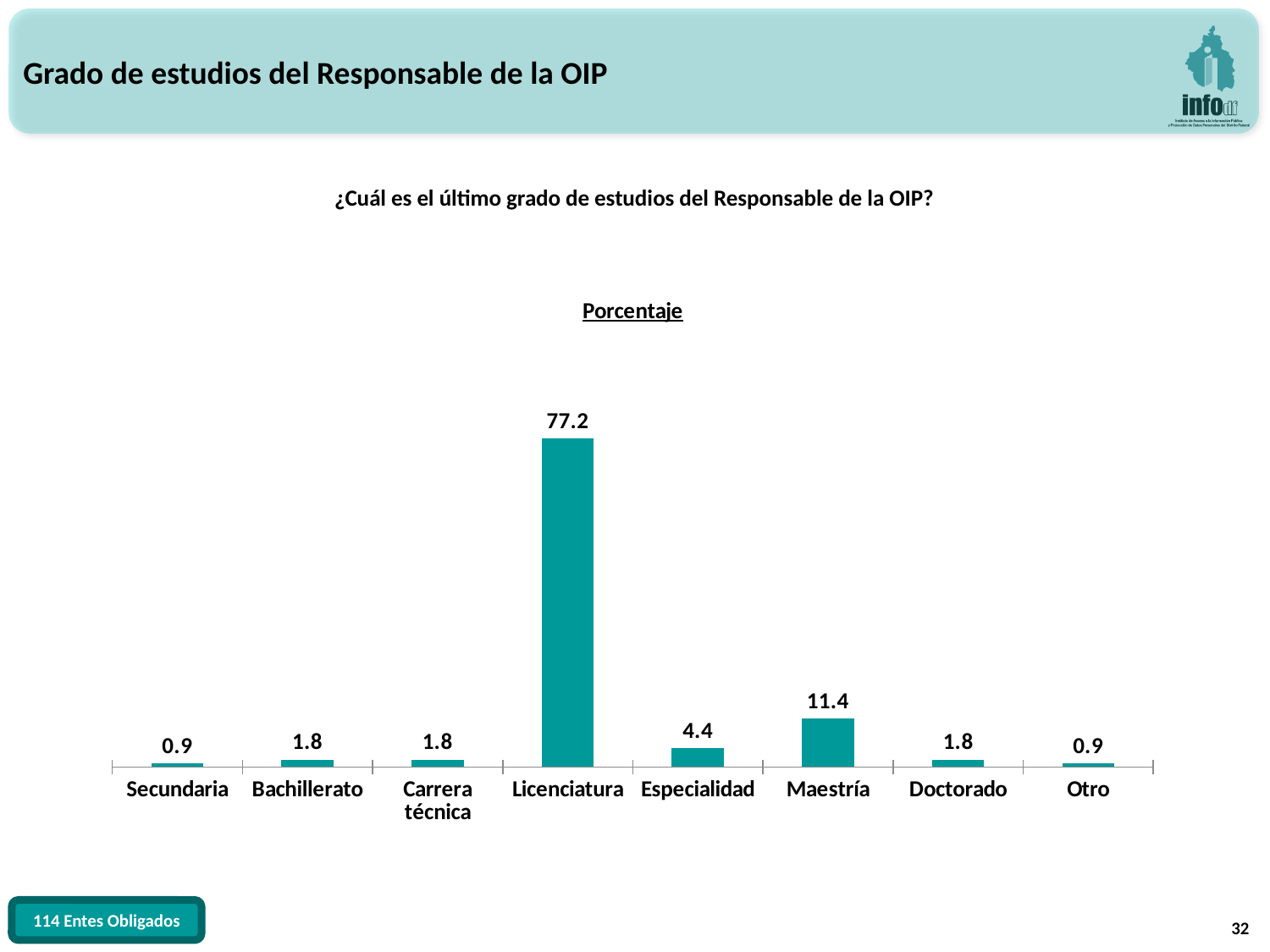
Which is larger, the value for Especialidad or the value for Doctorado? Especialidad What is the difference between the values for Licenciatura and Maestría? 65.8 How many categories are shown on the x axis? 8 What is the value for Especialidad? 4.4 What is the value for Maestría? 11.4 What is the difference between the values for Maestría and Especialidad? 7.0 Which category has the highest value? Licenciatura What is the value for Secundaria? 0.9 What is the title shown above the chart? Porcentaje What is the value for Licenciatura? 77.2 What kind of chart is shown on the slide? Bar chart What colour are the bars in the chart? Teal